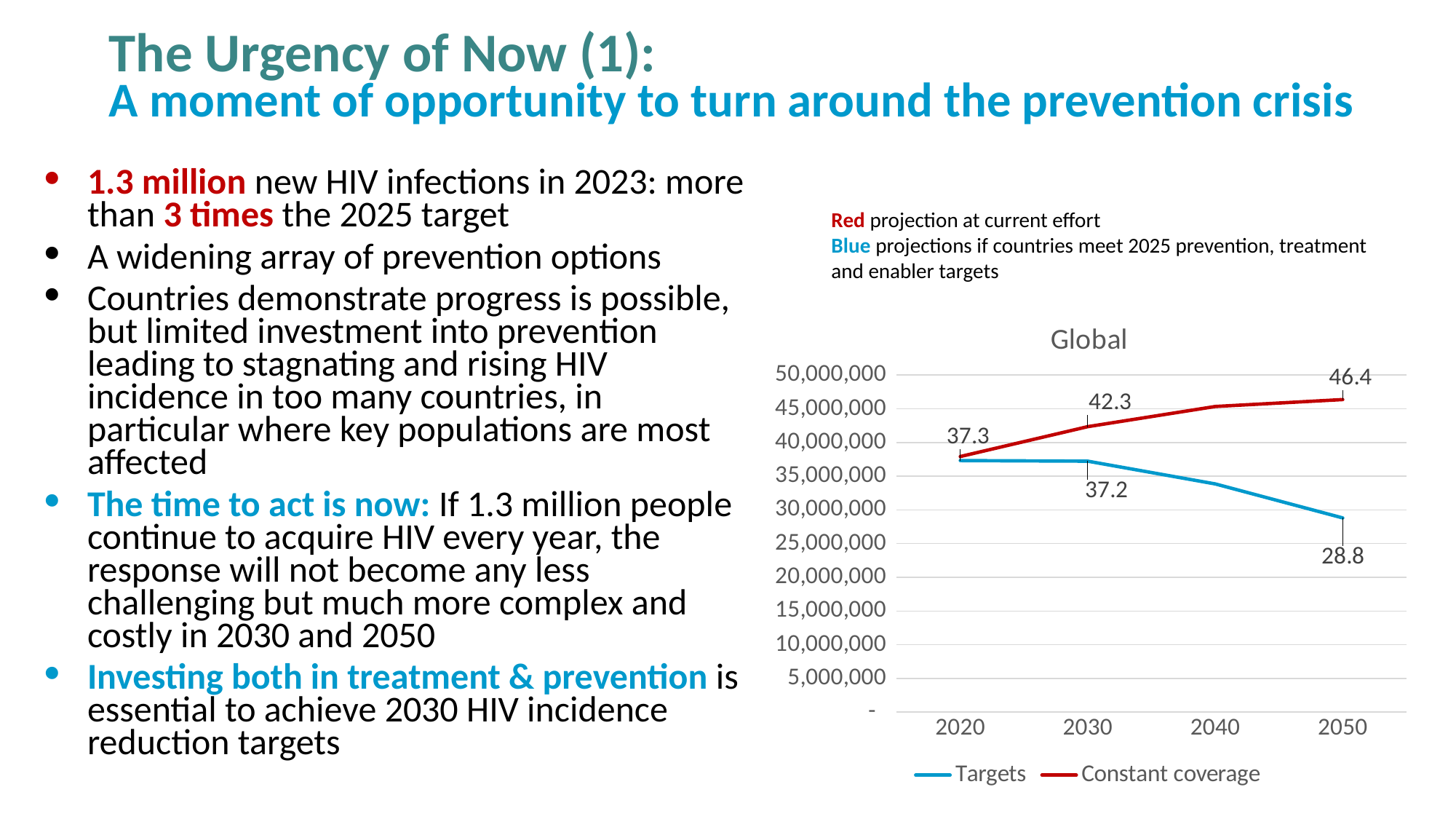
How many series does the chart legend list? 2 What kind of chart is shown on the slide? line chart What is the title of the chart? Global Is the value of the Constant coverage series in 2040 greater or less than 40,000,000? greater What is the value of the Targets series in 2050? 28.8 Does the Targets line rise or fall between 2030 and 2050? fall What is the value of the Constant coverage series in 2030? 42.3 What is the value of the Constant coverage series in 2050? 46.4 In 2030, which series has the larger value, Targets or Constant coverage? Constant coverage What is the value of the Targets series in 2030? 37.2 How many years are shown on the x axis of the chart? 4 What is the difference between the Constant coverage and Targets values in 2050? 17.6